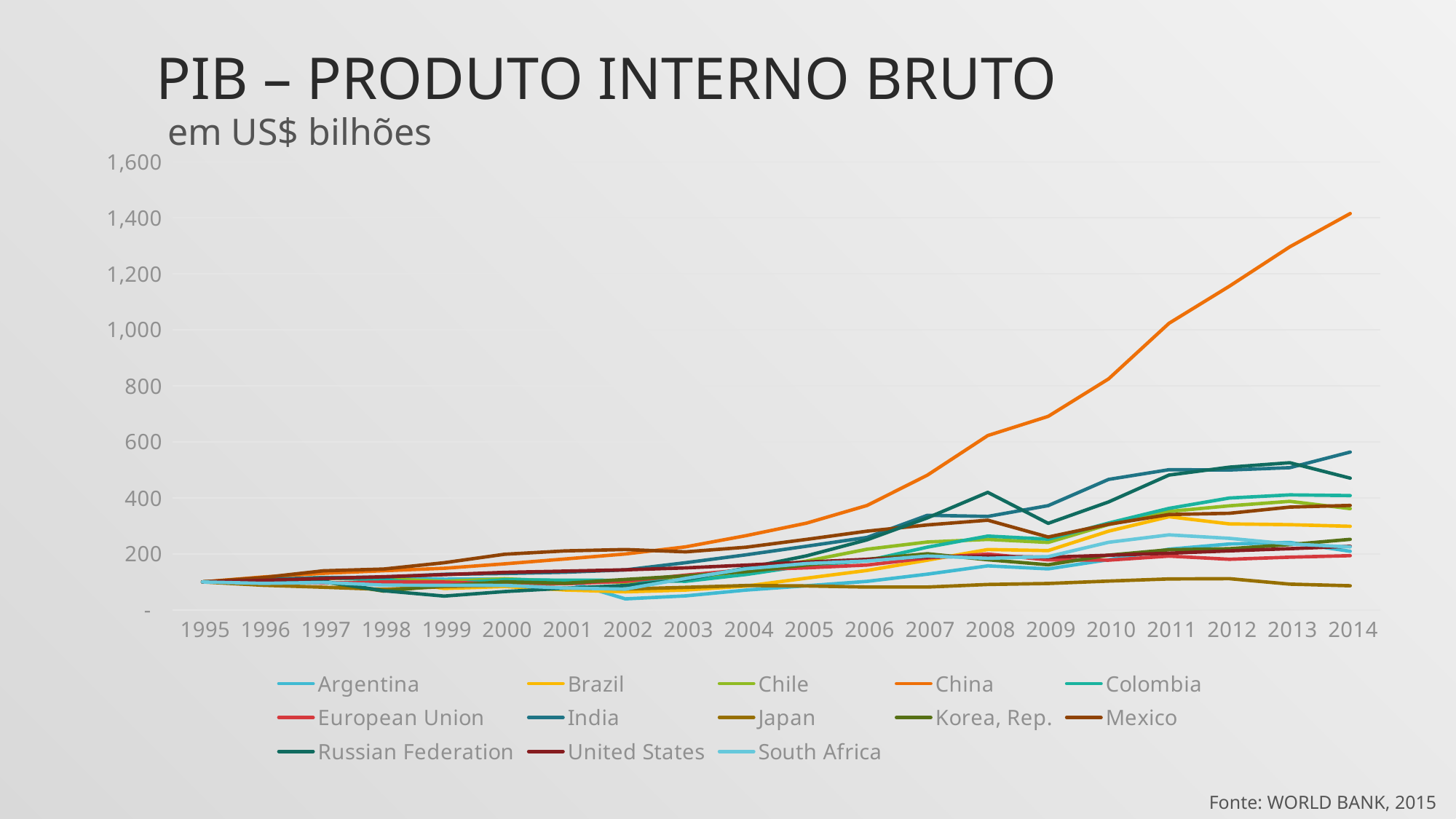
Is the value for China in 2012 greater or less than 1,000? greater Which series has the lowest value in 2014? Japan Does the value for China rise or fall from 1995 to 2014? rise Is the value for Japan in 2014 greater or less than 200? less Which series has the highest value in 2014? China How many years are shown along the x axis? 20 What is the title of the chart? PIB – PRODUTO INTERNO BRUTO Which is larger in 2014, the value for China or the value for India? China Is the value for China in 2014 greater or less than 1,200? greater How many series does the legend list? 13 What kind of chart is shown on the slide? line chart